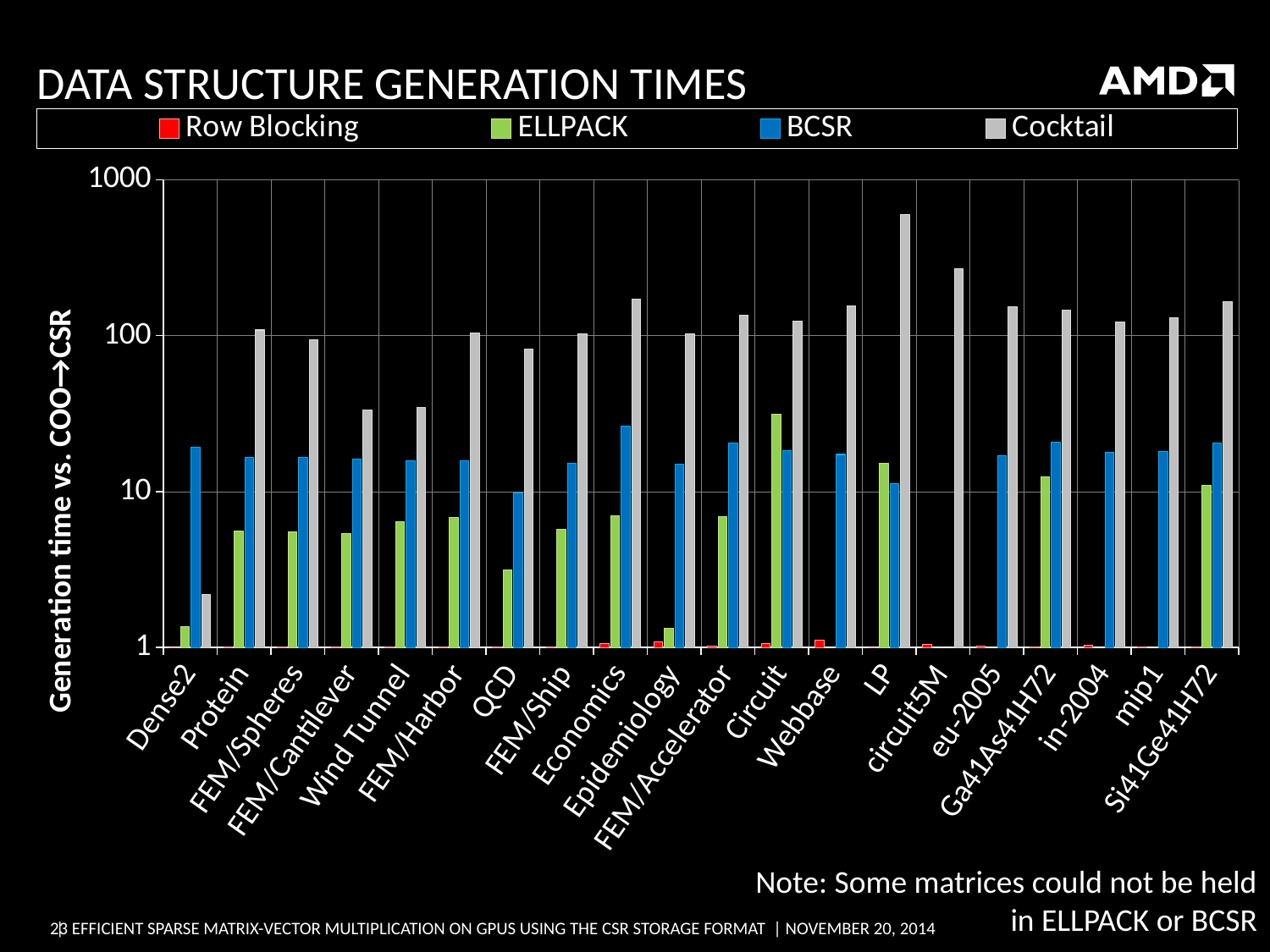
How many series does the legend list? 4 What kind of chart is shown on the slide? bar chart Is the Cocktail value for Dense2 greater or less than 10? less For which matrix is the ELLPACK generation time highest? Circuit For Protein, which is larger: the Cocktail value or the BCSR value? Cocktail For which matrix is the Cocktail generation time highest? LP How many matrices (categories) are shown on the x axis? 20 Is the Cocktail value for FEM/Cantilever greater or less than 100? less Is the ELLPACK value for Circuit greater or less than 10? greater What is the label of the y axis? Generation time vs. COO→CSR For which matrix is the Cocktail generation time lowest? Dense2